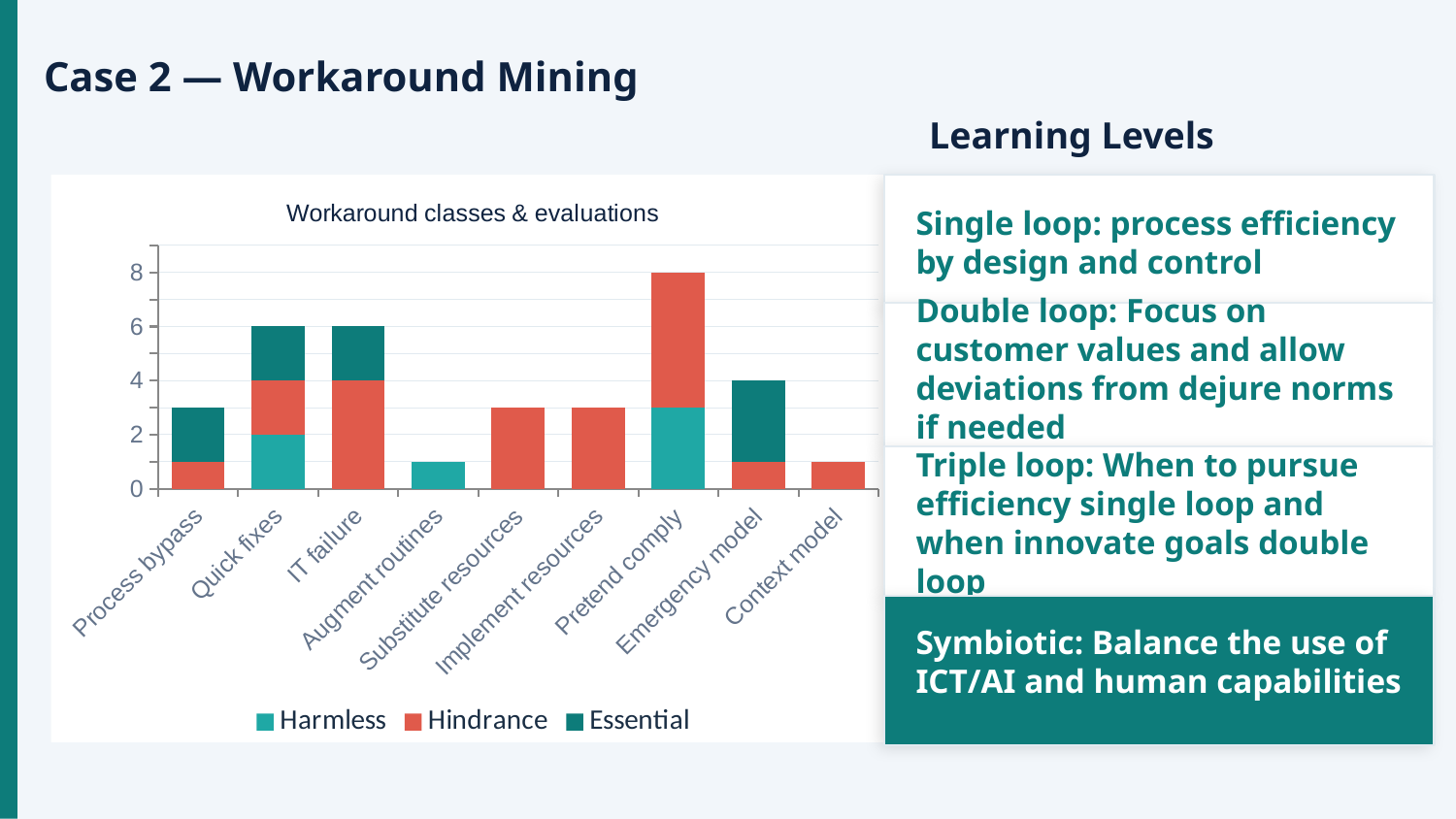
Is the total value for Augment routines greater or less than 2? less What is the difference between the total bar heights of Pretend comply and Emergency model? 4 What is the title of the chart? Workaround classes & evaluations What kind of chart is shown on the slide? Stacked bar chart What is the total bar height for Emergency model? 4 What is the Hindrance value for IT failure? 4 Which workaround class has the highest total bar in the chart? Pretend comply What is the total bar height for Pretend comply? 8 What is the Harmless value for Quick fixes? 2 How many workaround classes are shown on the x axis of the chart? 9 What is the total bar height for Quick fixes? 6 How many series does the chart legend list? 3